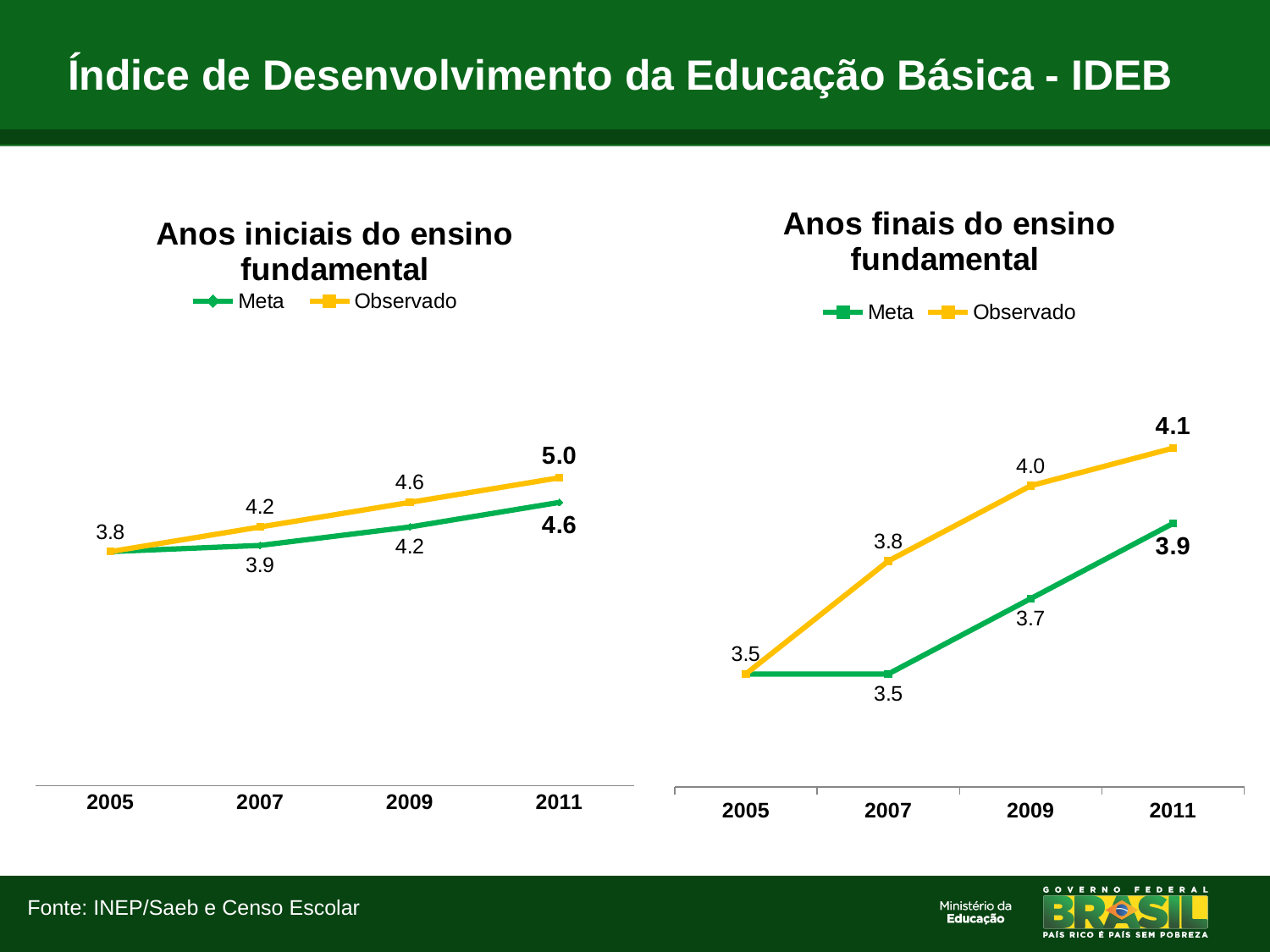
In the 'Anos iniciais do ensino fundamental' chart, what is the Observado value for 2011? 5.0 In the 'Anos iniciais do ensino fundamental' chart, what is the difference between the Observado and Meta values in 2011? 0.4 How many years are shown on the x axis of the 'Anos iniciais do ensino fundamental' chart? 4 In the 'Anos finais do ensino fundamental' chart, is the Observado value for 2009 larger than the Meta value for 2009? Yes In the 'Anos finais do ensino fundamental' chart, what is the difference between the Observado and Meta values in 2007? 0.3 In the 'Anos iniciais do ensino fundamental' chart, which year has the lowest Meta value? 2005 What type of chart is the 'Anos iniciais do ensino fundamental' chart? Line chart In the 'Anos finais do ensino fundamental' chart, which year has the highest Observado value? 2011 How many series does the legend of the 'Anos finais do ensino fundamental' chart list? 2 In the 'Anos finais do ensino fundamental' chart, what is the Meta value for 2011? 3.9 In the 'Anos finais do ensino fundamental' chart, what is the Observado value for 2009? 4.0 In the 'Anos iniciais do ensino fundamental' chart, what is the Meta value for 2009? 4.2